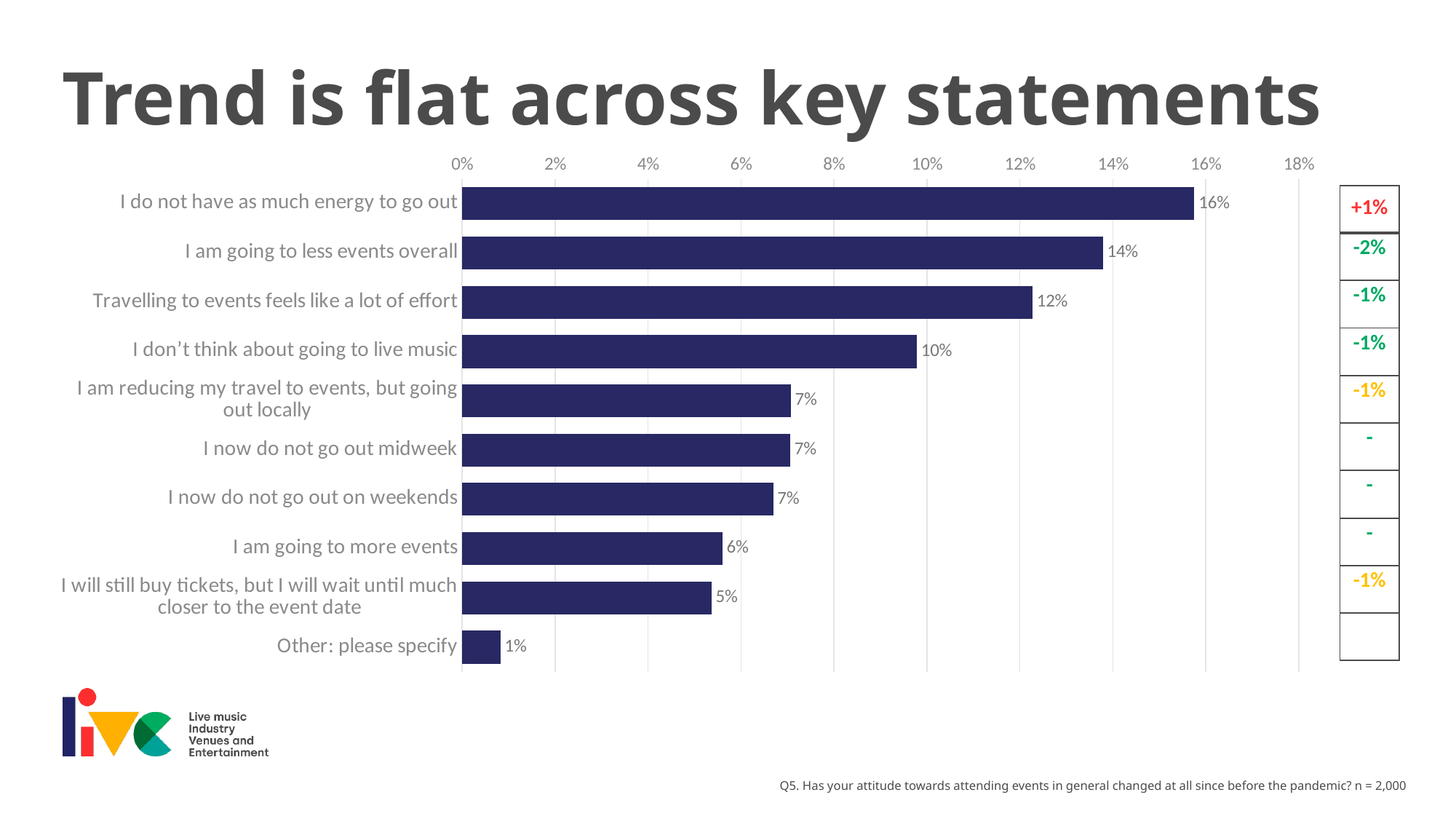
What is the value for "I will still buy tickets, but I will wait until much closer to the event date"? 5% What is the value for "Travelling to events feels like a lot of effort"? 12% What kind of chart is shown on the slide? bar chart Is the value for "I am going to more events" greater or less than 4%? greater What is the difference between "I do not have as much energy to go out" and "I am going to less events overall"? 2% Do the bar values increase or decrease going from the top statement to the bottom statement? decrease What is the value for "I do not have as much energy to go out"? 16% What is the title of the slide? Trend is flat across key statements Which statement has the lowest value? Other: please specify Which is larger: "I don't think about going to live music" or "I am going to more events"? I don't think about going to live music Which statement has the highest value? I do not have as much energy to go out How many statements are plotted in the chart? 10